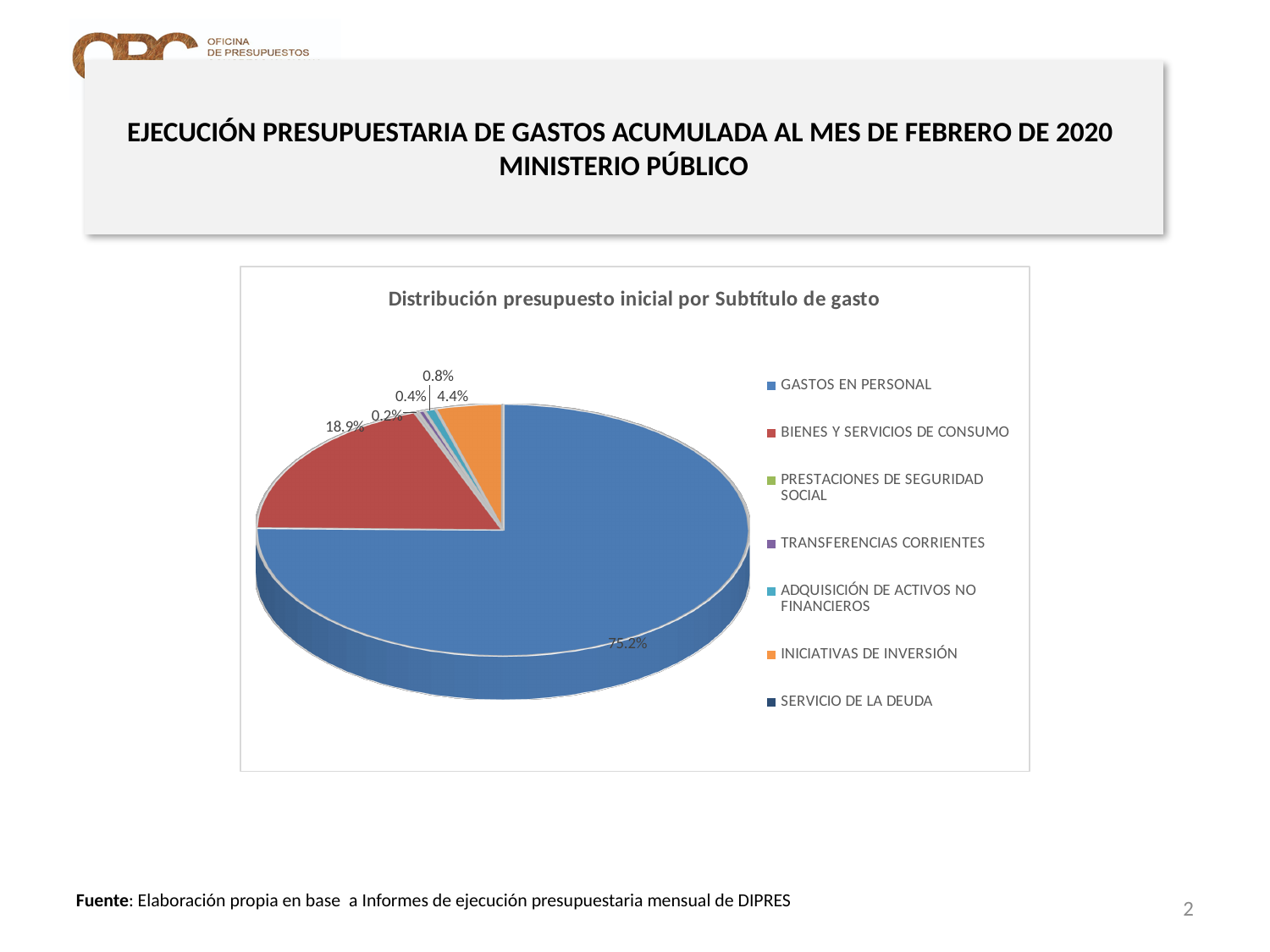
What is the difference in percentage points between the share for GASTOS EN PERSONAL and the share for BIENES Y SERVICIOS DE CONSUMO? 56.3 percentage points What share of the pie does BIENES Y SERVICIOS DE CONSUMO represent? 18.9% What is the smallest percentage label shown on the pie chart? 0.2% What is the combined share of GASTOS EN PERSONAL and BIENES Y SERVICIOS DE CONSUMO? 94.1% How many categories does the chart legend list? 7 What share of the pie does GASTOS EN PERSONAL represent? 75.2% What type of chart is shown on the slide? Pie chart Is the share for GASTOS EN PERSONAL greater or less than 50%? greater Which category has the largest share of the pie? GASTOS EN PERSONAL What is the title of the chart? Distribución presupuesto inicial por Subtítulo de gasto What share of the pie does INICIATIVAS DE INVERSIÓN represent? 4.4% Which is larger, the share for BIENES Y SERVICIOS DE CONSUMO or the share for INICIATIVAS DE INVERSIÓN? BIENES Y SERVICIOS DE CONSUMO